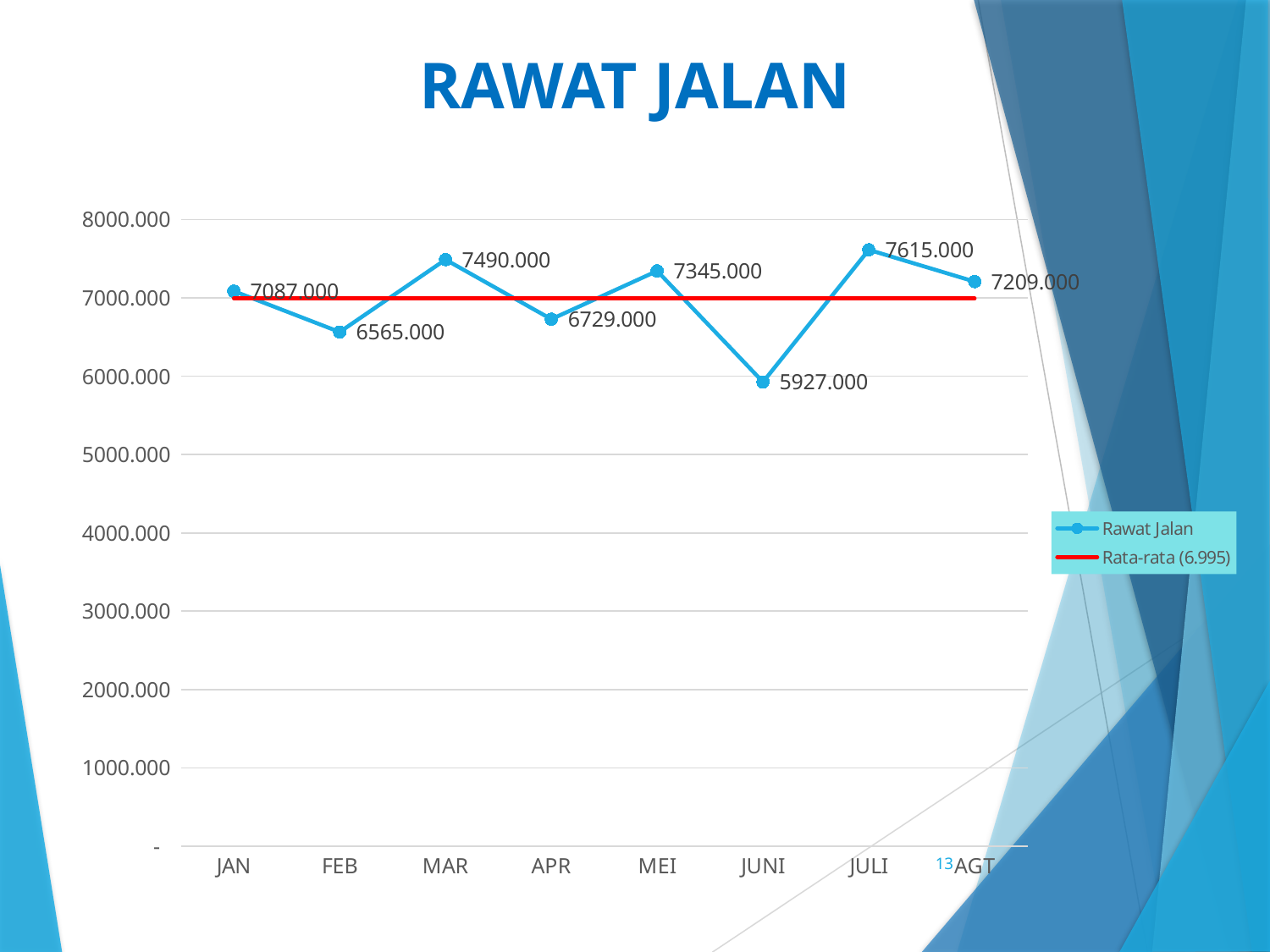
What is the value for JUNI in the Rawat Jalan chart? 5927.000 What average value is given in the legend entry for the red line? 6.995 What is the value for AGT in the Rawat Jalan chart? 7209.000 Which month has the highest Rawat Jalan value? JULI Is the Rawat Jalan value for APR greater or less than 7000.000? less How many series does the legend list? 2 Which is larger, the Rawat Jalan value for JAN or for FEB? JAN Which month has the lowest Rawat Jalan value? JUNI What is the value for MAR in the Rawat Jalan chart? 7490.000 What is the difference between the Rawat Jalan values for JULI and JUNI? 1688.000 How many months are plotted on the x axis of the chart? 8 What kind of chart is shown on the slide? line chart